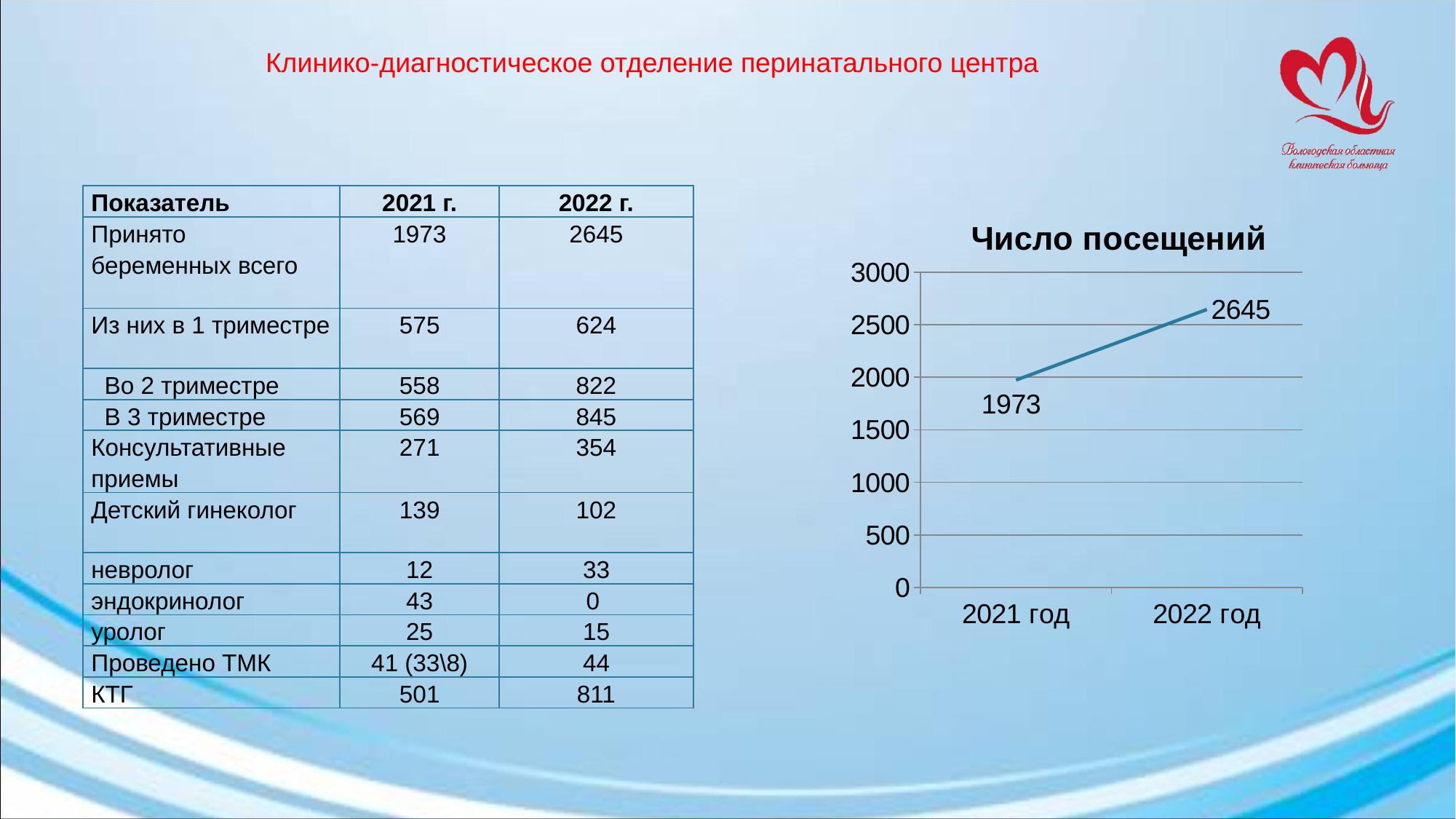
Which year has the higher number of visits in the chart? 2022 год What is the difference between the 2022 год and 2021 год values in the chart? 672 Which year has the lower number of visits in the chart? 2021 год What is the title of the chart? Число посещений Is the value for 2022 год greater or less than 2500? greater What kind of chart is shown on the slide? line chart What is the highest value shown on the chart's vertical axis? 3000 How many data points are plotted in the chart? 2 What is the value for 2022 год in the chart? 2645 Do the values rise or fall from 2021 год to 2022 год? rise What is the value for 2021 год in the chart? 1973 Is the value for 2021 год greater or less than 2000? less